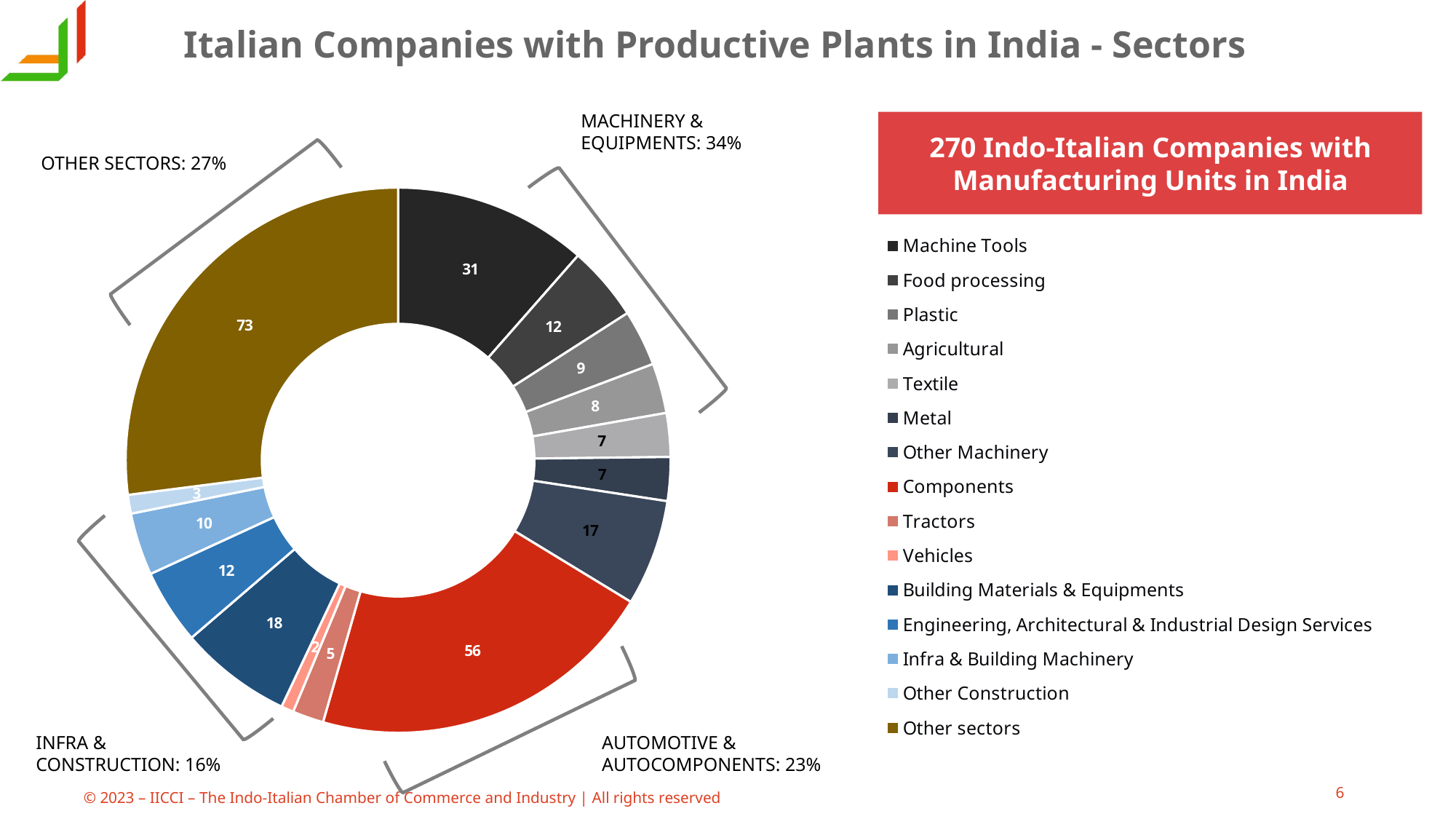
What is the value shown for Building Materials & Equipments? 18 Which category has the smallest slice? Vehicles What share of the total does the Infra & Construction group represent? 16% What share of the total does the Machinery & Equipments group represent? 34% How many categories does the legend list? 15 What kind of chart is shown on the slide? pie chart (donut) What is the value shown for Machine Tools? 31 What is the total number of Indo-Italian companies with manufacturing units in India stated on the slide? 270 Which is larger, Other Machinery or Food processing? Other Machinery Which category has the largest slice? Other sectors What is the difference between the Other sectors value and the Components value? 17 How many companies are in the Components slice? 56